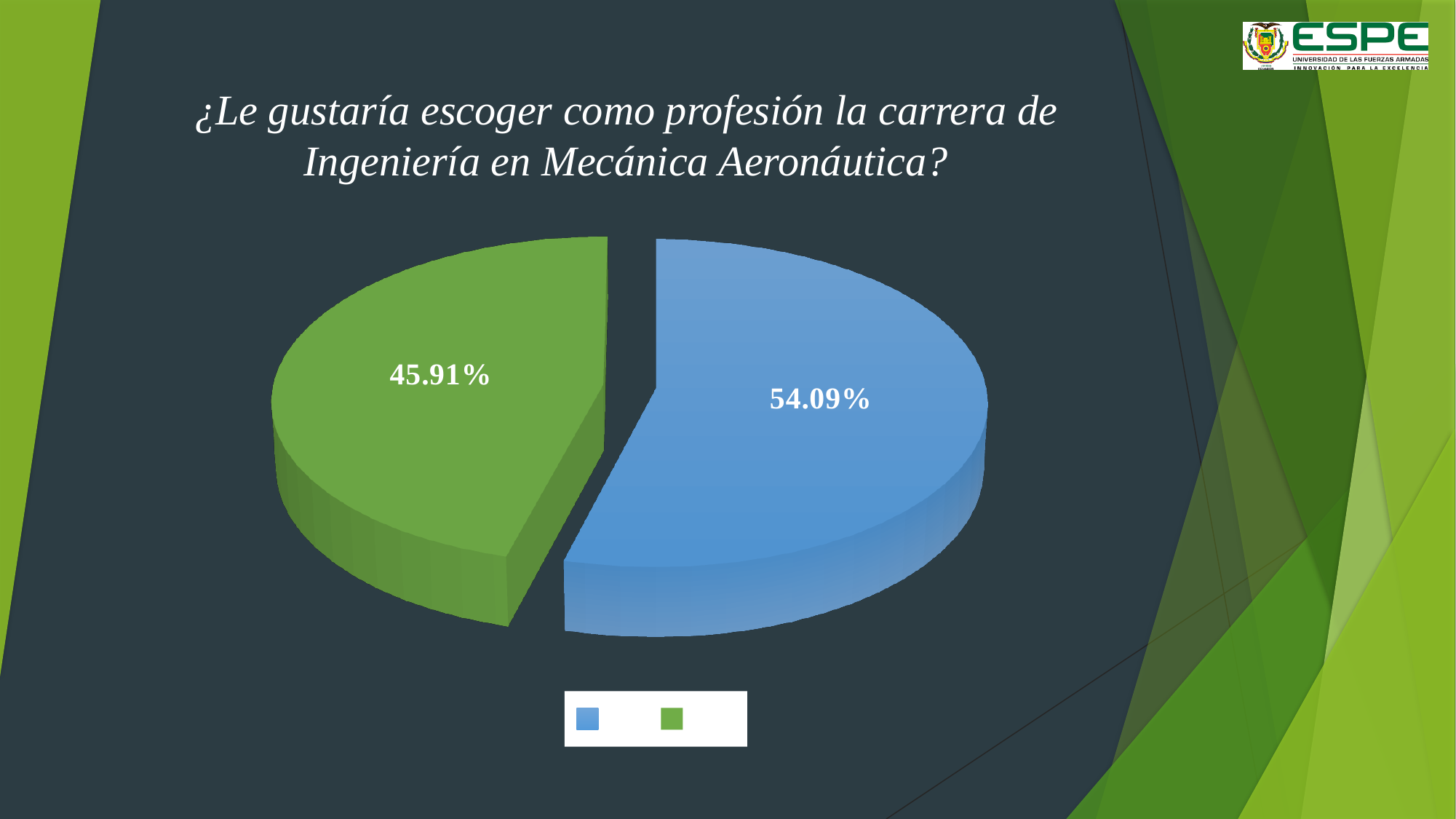
Which slice of the pie chart is the smallest, the blue one or the green one? the green one What percentage is shown on the green slice of the pie chart? 45.91% Is the blue slice larger or smaller than the green slice? larger What question is written as the title above the pie chart? ¿Le gustaría escoger como profesión la carrera de Ingeniería en Mecánica Aeronáutica? How many entries does the legend below the pie chart show? 2 Which slice of the pie chart is the largest, the blue one or the green one? the blue one What percentage is shown on the blue slice of the pie chart? 54.09% How many slices does the pie chart have? 2 What is the difference in percentage points between the blue slice and the green slice? 8.18 What share of the pie does the green slice represent? 45.91% What kind of chart is shown on the slide? pie chart What do the two slice percentages add up to? 100%